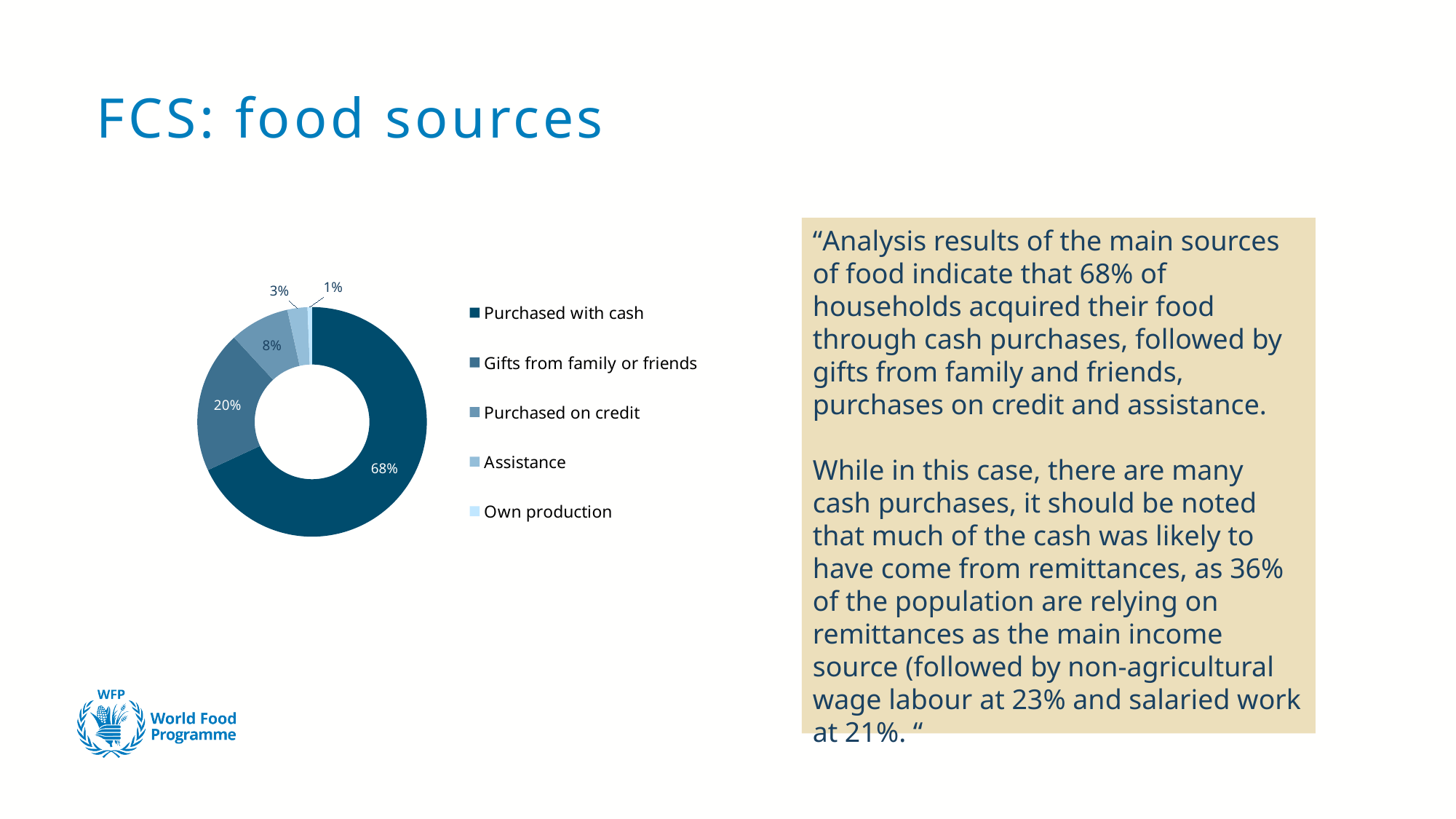
What percentage does the chart show for Own production? 1% What share of the pie chart is Purchased with cash? 68% Which is larger, the share for Purchased on credit or the share for Assistance? Purchased on credit What is the difference in percentage points between Purchased with cash and Gifts from family or friends? 48 What percentage does the chart show for Assistance? 3% What percentage does the chart show for Purchased on credit? 8% How many food source categories does the chart show? 5 Which food source has the largest share in the chart? Purchased with cash What percentage does the chart show for Gifts from family or friends? 20% Which food source has the smallest share in the chart? Own production What kind of chart is shown on the slide? Pie chart (doughnut) What is the title of the slide containing the chart? FCS: food sources